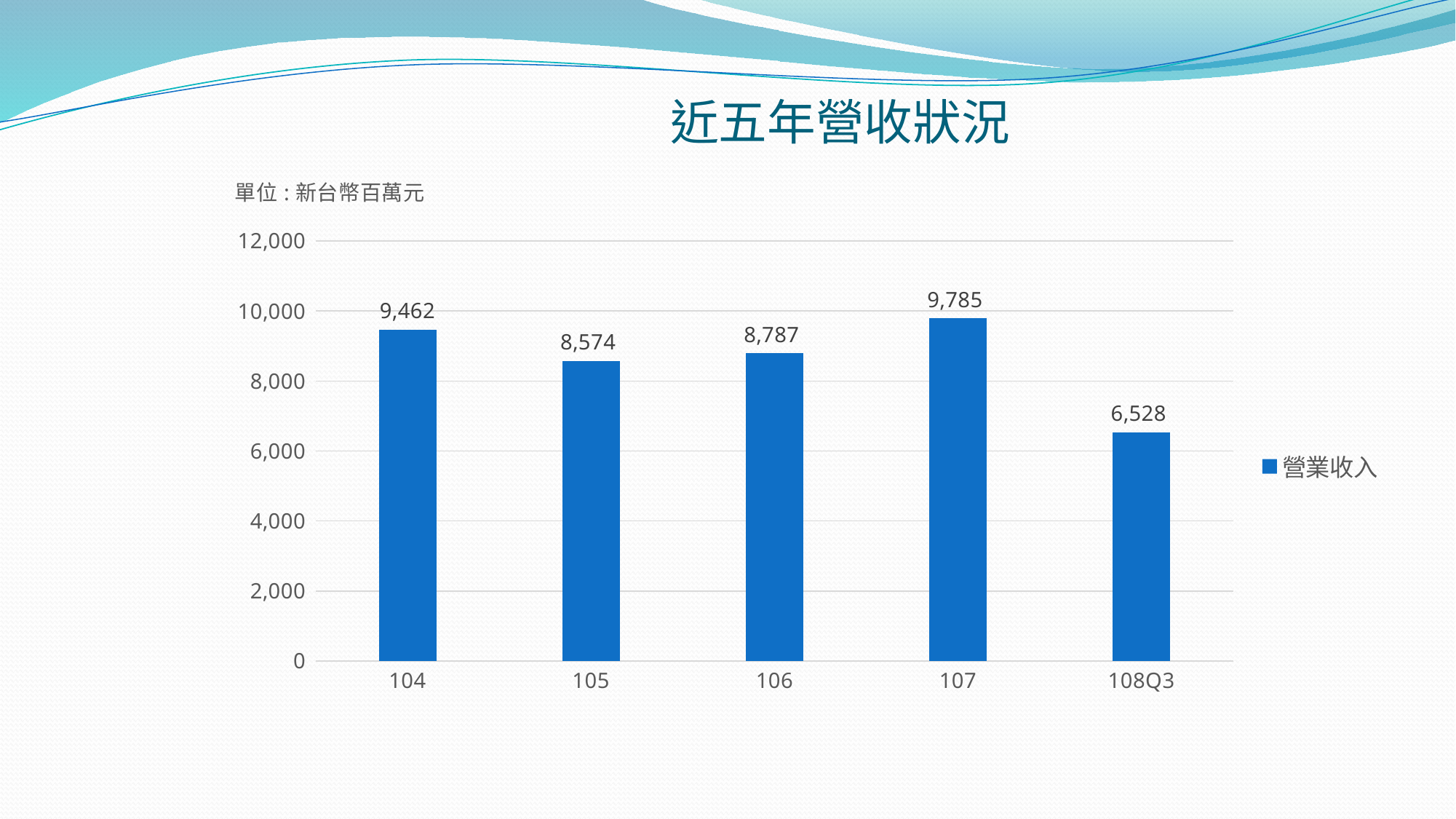
What is the value for 104? 9,462 What is the value for 105? 8,574 How many categories are shown on the x axis? 5 What is the difference between the values for 107 and 106? 998 What series name does the legend list? 營業收入 Which category has the highest value? 107 What is the value for 108Q3? 6,528 What kind of chart is shown on the slide? bar chart Which category has the lowest value? 108Q3 Is the value for 108Q3 greater or less than 8,000? less What is the difference between the values for 104 and 105? 888 Which is larger, the value for 106 or the value for 105? 106